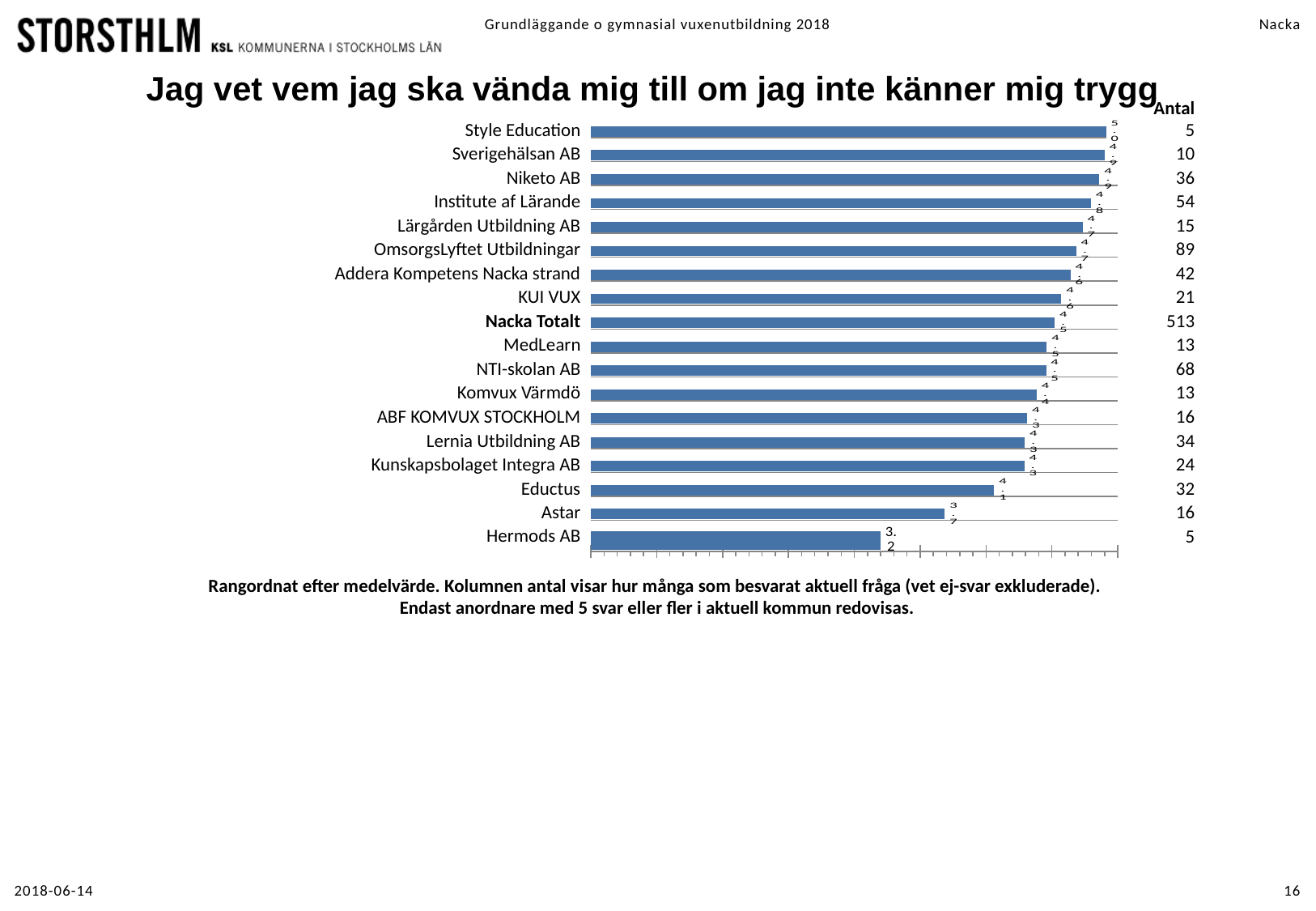
Which has a larger value, Eductus or Astar? Eductus Do the bar values rise or fall going from the top of the chart to the bottom? fall Which category has the highest value in the chart? Style Education What is the value for Hermods AB? 3.2 What type of chart is shown on the slide? bar chart What is the title of the chart? Jag vet vem jag ska vända mig till om jag inte känner mig trygg What is the difference between the values for Style Education and Hermods AB? 1.8 Which category has the lowest value in the chart? Hermods AB What is the value for Nacka Totalt? 4.5 What is the value for Astar? 3.7 How many categories (bars) does the chart show? 18 What is the value for Style Education? 5.0